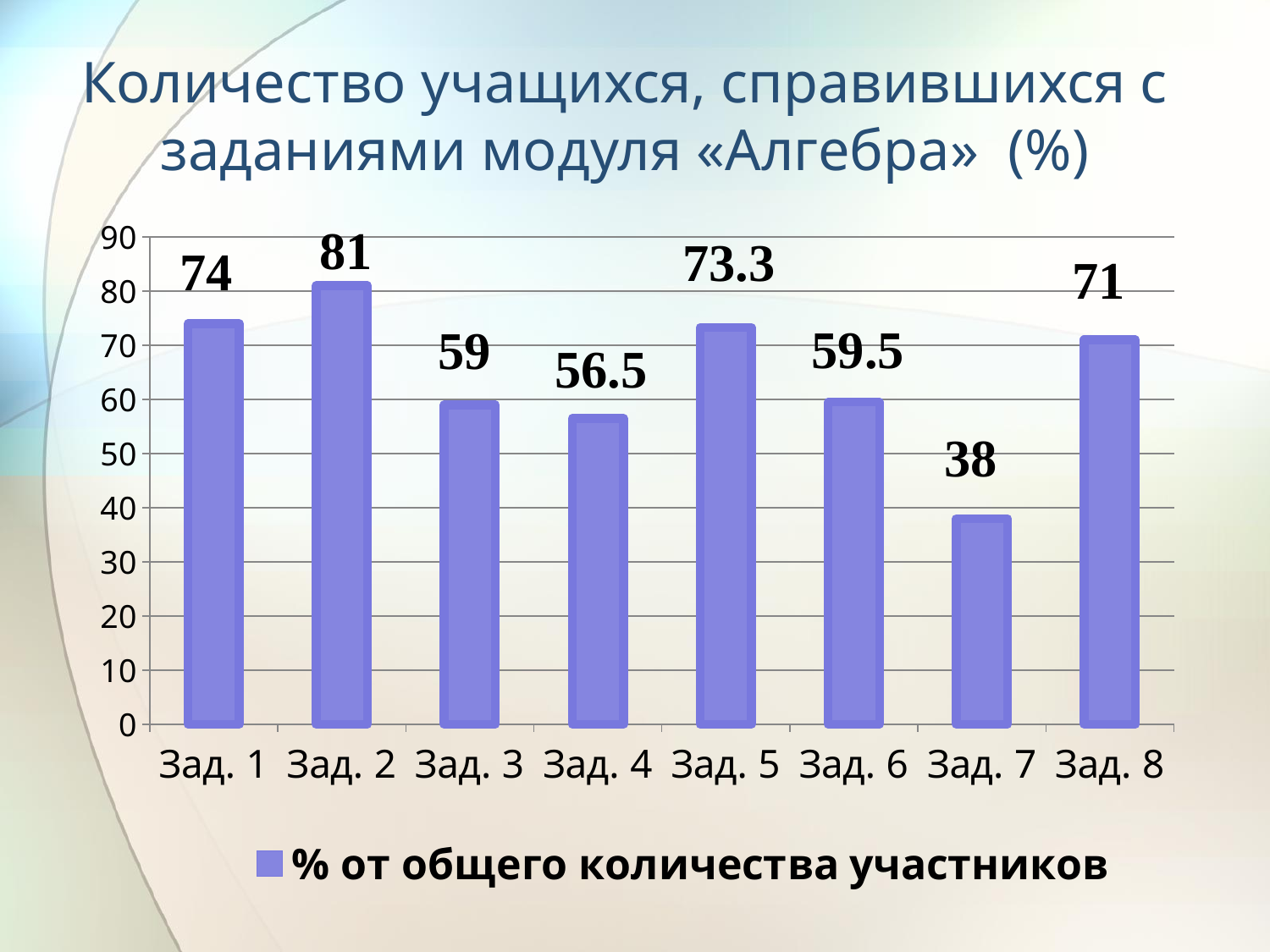
What is the difference between the values for Зад. 2 and Зад. 7? 43 Is the value for Зад. 3 greater or less than 50? greater What is the legend entry for the series? % от общего количества участников What kind of chart is shown on the slide? bar chart Which task has the highest value? Зад. 2 Which is larger, the value for Зад. 1 or the value for Зад. 8? Зад. 1 What is the value for Зад. 7? 38 How many tasks are shown on the x axis? 8 Which task has the lowest value? Зад. 7 What is the difference between the values for Зад. 6 and Зад. 4? 3 What is the value for Зад. 1? 74 What is the value for Зад. 5? 73.3